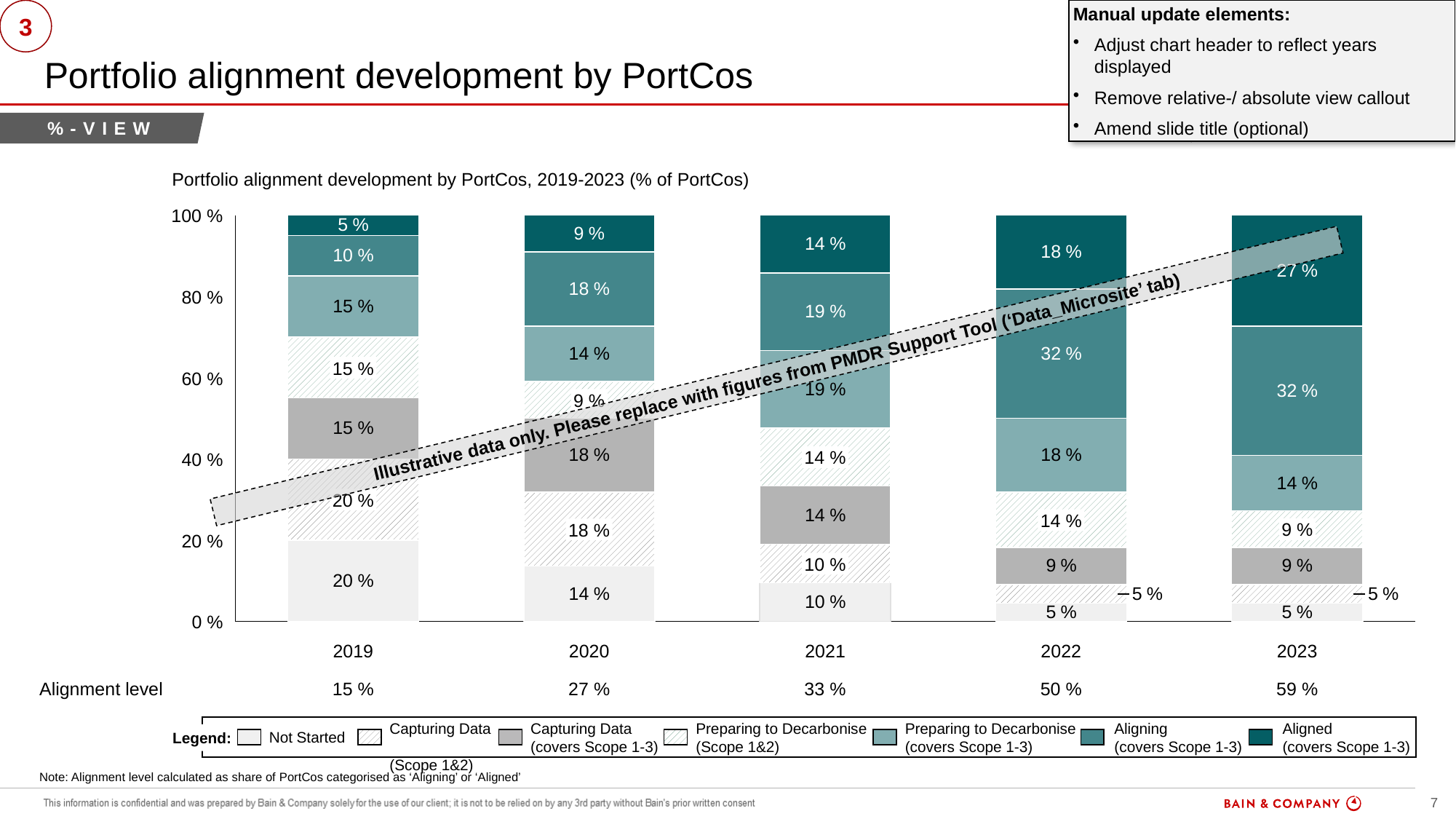
How many years are shown on the x axis of the chart? 5 Does the Alignment level rise or fall from 2019 to 2023? Rise What is the value for the Aligned (covers Scope 1-3) segment in 2023? 27 % What kind of chart is shown on the slide? Stacked bar chart How many series does the legend list? 7 Which year has the larger Aligning (covers Scope 1-3) segment, 2020 or 2022? 2022 What is the value for the Aligning (covers Scope 1-3) segment in 2022? 32 % In which year is the Aligned (covers Scope 1-3) segment the largest? 2023 In which year is the Aligned (covers Scope 1-3) segment the smallest? 2019 What is the value for the Not Started segment in 2019? 20 % What is the Alignment level shown for 2023? 59 % What is the difference in percentage points between the Aligned (covers Scope 1-3) segment in 2023 and in 2019? 22 percentage points